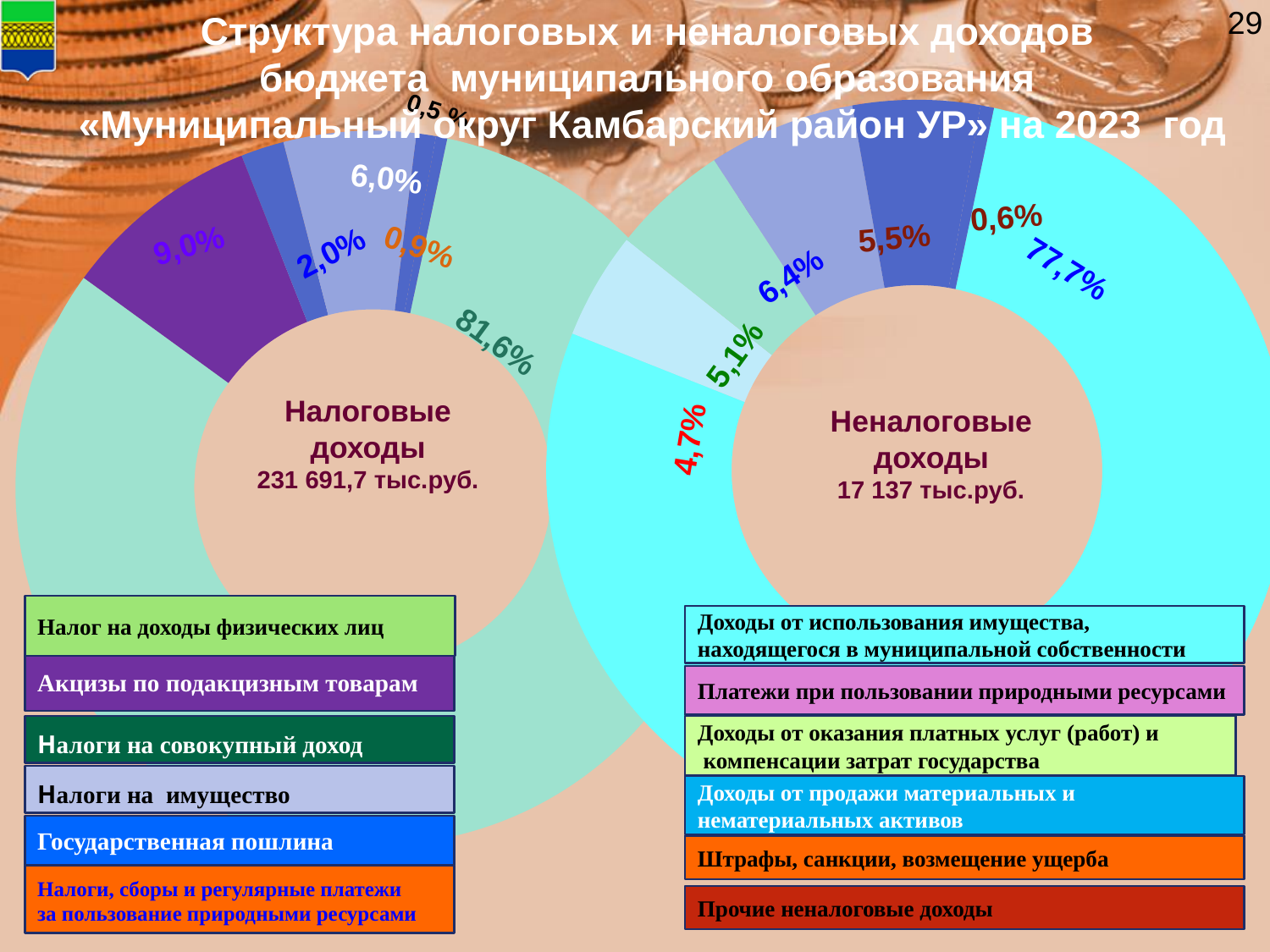
In the right chart (Неналоговые доходы), what is the smallest slice's share? 0,6% In the right chart (Неналоговые доходы), which is larger: the 6,4% slice or the 5,5% slice? 6,4% In the left chart (Налоговые доходы), what is the largest slice's share? 81,6% What kind of charts are shown on the slide? Doughnut (pie) charts In the left chart (Налоговые доходы), what share does the purple slice (Акцизы по подакцизным товарам) have? 9,0% In the left chart (Налоговые доходы), what is the smallest slice's share? 0,5% In the right chart (Неналоговые доходы), what is the largest slice's share? 77,7% In the left chart (Налоговые доходы), what is the difference between the 81,6% slice and the 9,0% slice? 72,6% How many slices does the left chart (Налоговые доходы) have? 6 What total amount is printed in the centre of the right chart (Неналоговые доходы)? 17 137 тыс.руб. What total amount is printed in the centre of the left chart (Налоговые доходы)? 231 691,7 тыс.руб. How many legend entries are listed under the right chart (Неналоговые доходы)? 6